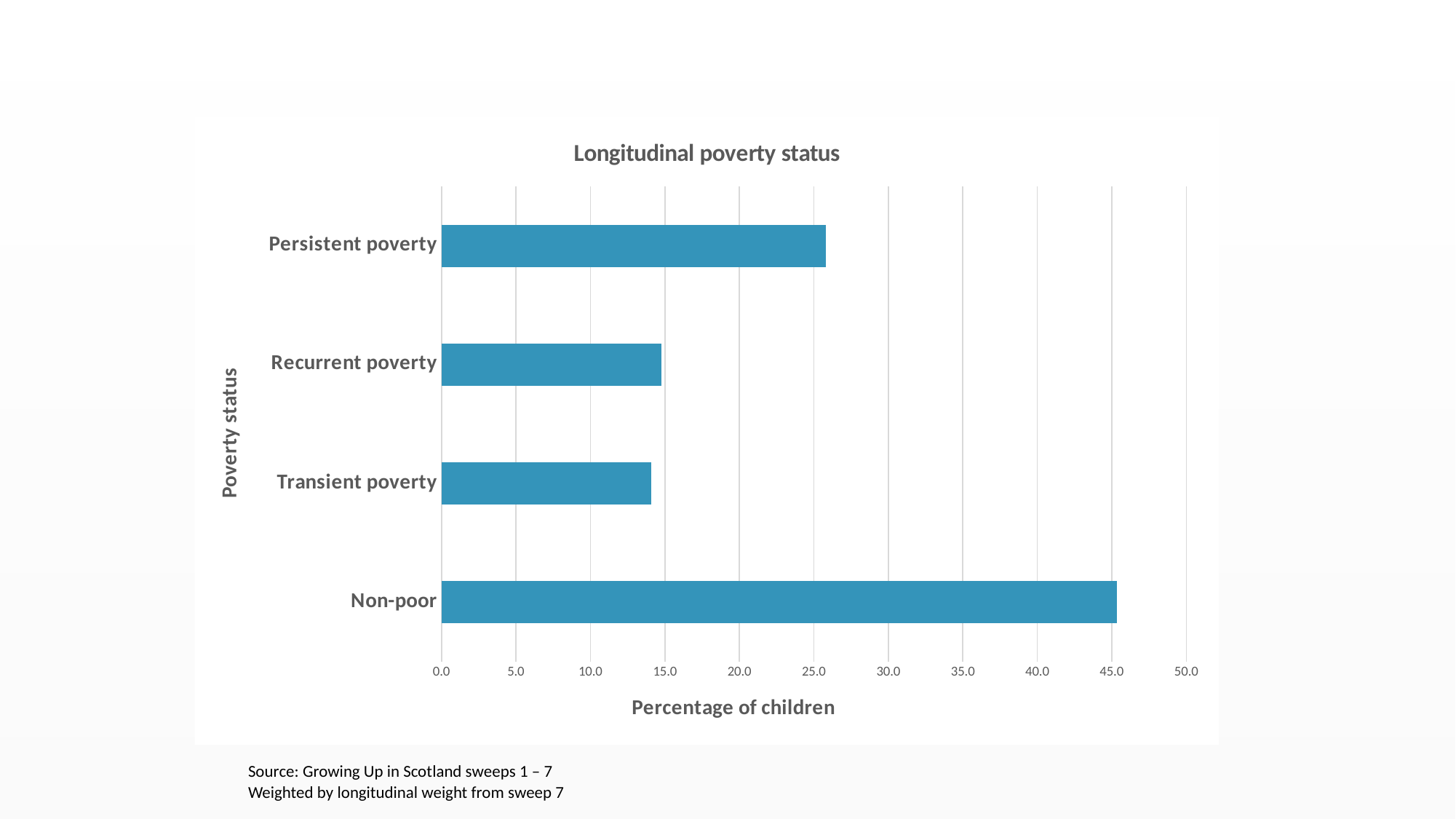
What is the title of the chart? Longitudinal poverty status Is the value for Non-poor greater or less than 40.0? greater What is the label of the horizontal axis? Percentage of children Is the value for Transient poverty greater or less than 20.0? less Is the value for Recurrent poverty greater or less than 10.0? greater What kind of chart is shown on the slide? bar chart Which is larger, the value for Non-poor or the value for Transient poverty? Non-poor How many poverty status categories are plotted in the chart? 4 Which poverty status category has the highest percentage of children? Non-poor Which is larger, the value for Persistent poverty or the value for Recurrent poverty? Persistent poverty